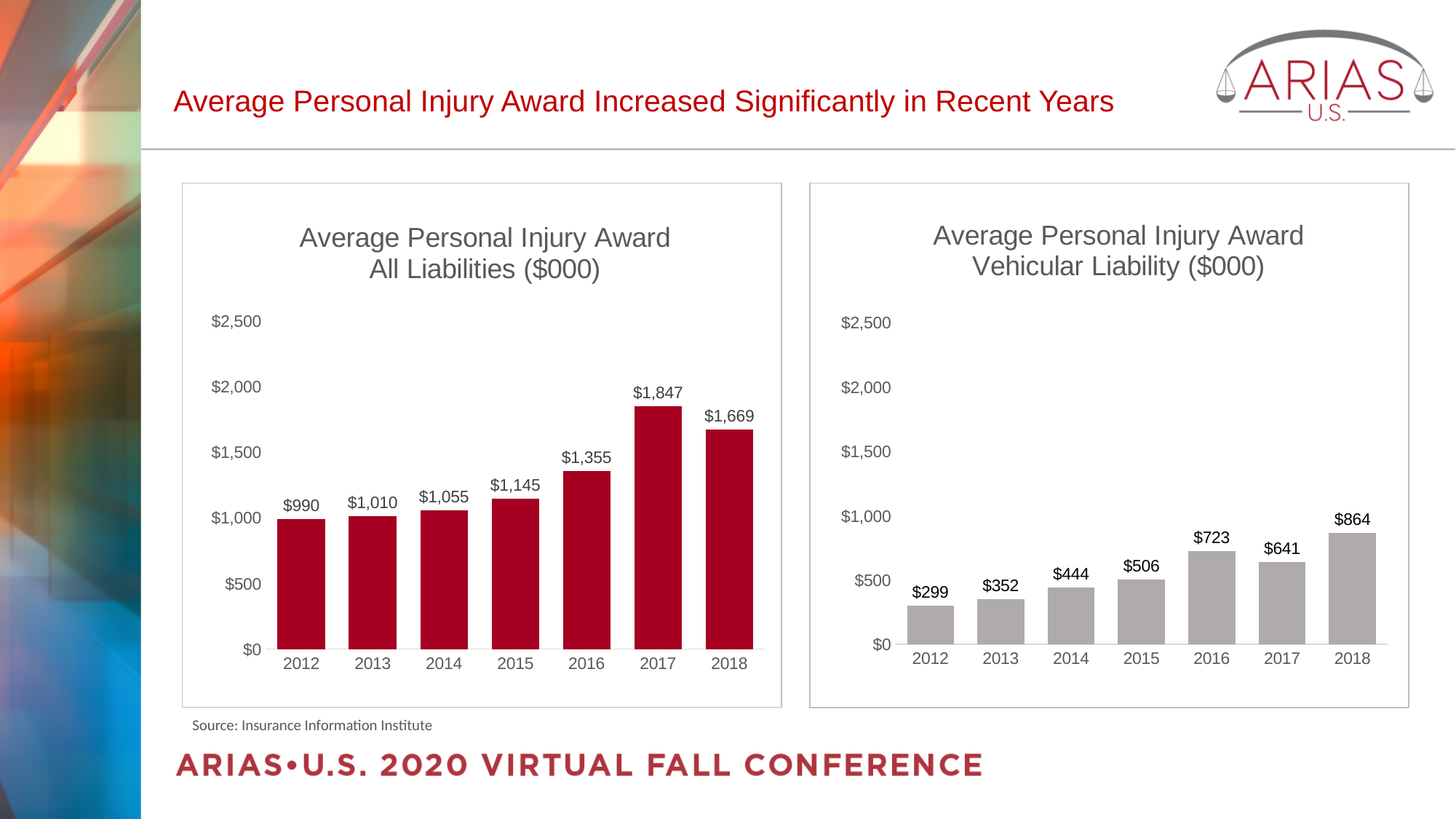
In the 'Average Personal Injury Award Vehicular Liability ($000)' chart, which year has the lowest value? 2012 In the 'Average Personal Injury Award All Liabilities ($000)' chart, which year has the highest value? 2017 In the 'Average Personal Injury Award All Liabilities ($000)' chart, is the value for 2015 greater or less than $1,000? greater In the 'Average Personal Injury Award Vehicular Liability ($000)' chart, which is larger, the value for 2016 or the value for 2017? 2016 What colour are the bars in the 'Average Personal Injury Award Vehicular Liability ($000)' chart? Gray In the 'Average Personal Injury Award Vehicular Liability ($000)' chart, what is the difference between the 2018 and 2012 values? $565 What kind of chart is the 'Average Personal Injury Award All Liabilities ($000)' chart? Bar chart In the 'Average Personal Injury Award All Liabilities ($000)' chart, what is the value for 2016? $1,355 How many years are shown on the x axis of the 'Average Personal Injury Award Vehicular Liability ($000)' chart? 7 In the 'Average Personal Injury Award All Liabilities ($000)' chart, what is the difference between the 2017 and 2018 values? $178 In the 'Average Personal Injury Award All Liabilities ($000)' chart, do the values rise or fall from 2012 to 2017? Rise In the 'Average Personal Injury Award Vehicular Liability ($000)' chart, what is the value for 2014? $444